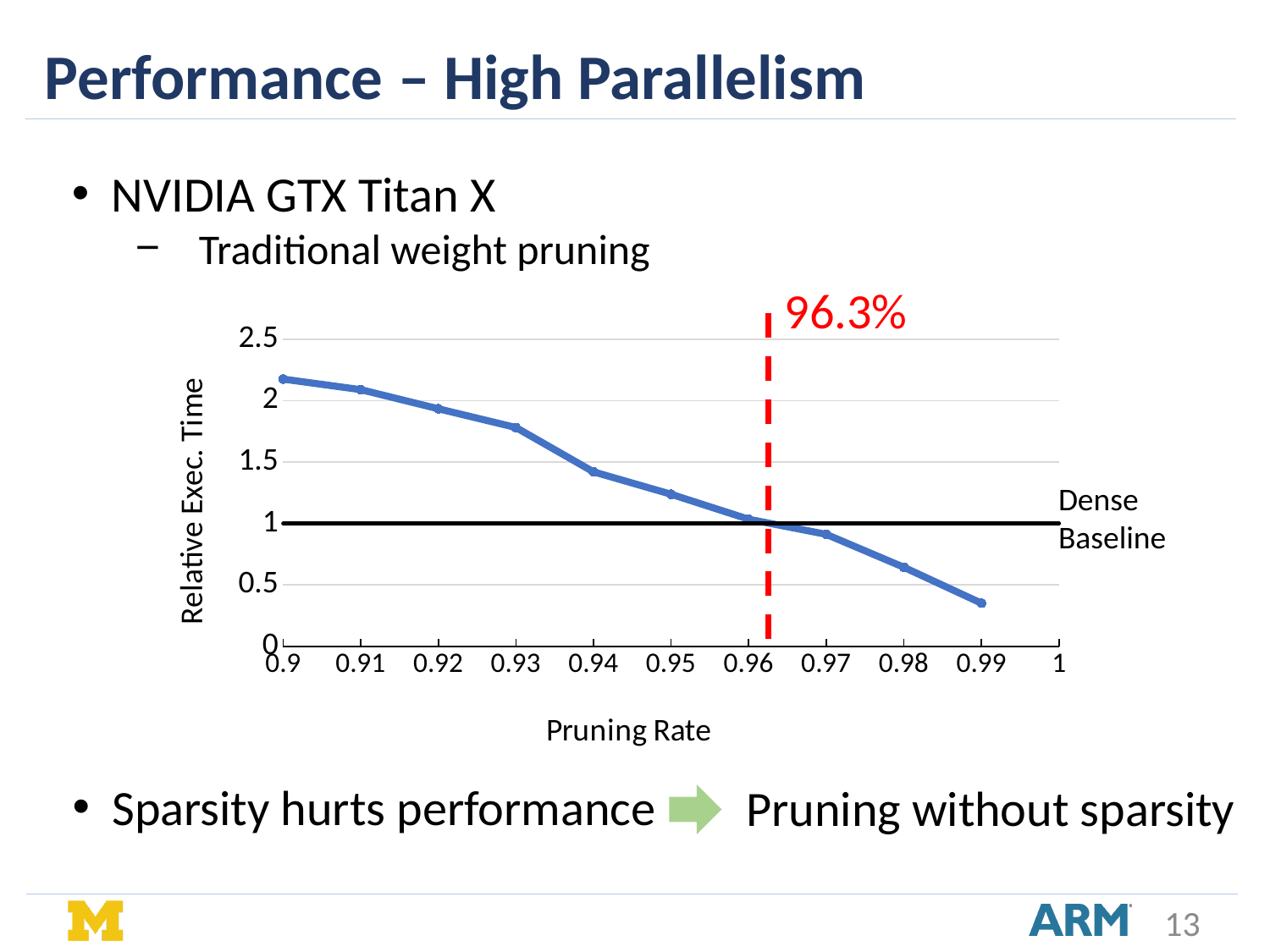
Is the relative execution time at a pruning rate of 0.9 greater or less than 2? greater What is the title of the x axis of the chart? Pruning Rate What kind of chart is shown on the slide? line chart At which pruning rate is the relative execution time lowest? 0.99 How many data points are plotted on the blue line? 10 Which has the larger relative execution time, a pruning rate of 0.92 or a pruning rate of 0.97? 0.92 Is the relative execution time at a pruning rate of 0.99 greater or less than 0.5? less At which pruning rate is the relative execution time highest? 0.9 Is the relative execution time at a pruning rate of 0.98 greater or less than 1? less What is the title of the y axis of the chart? Relative Exec. Time Does the relative execution time rise or fall as the pruning rate increases along the x axis? fall